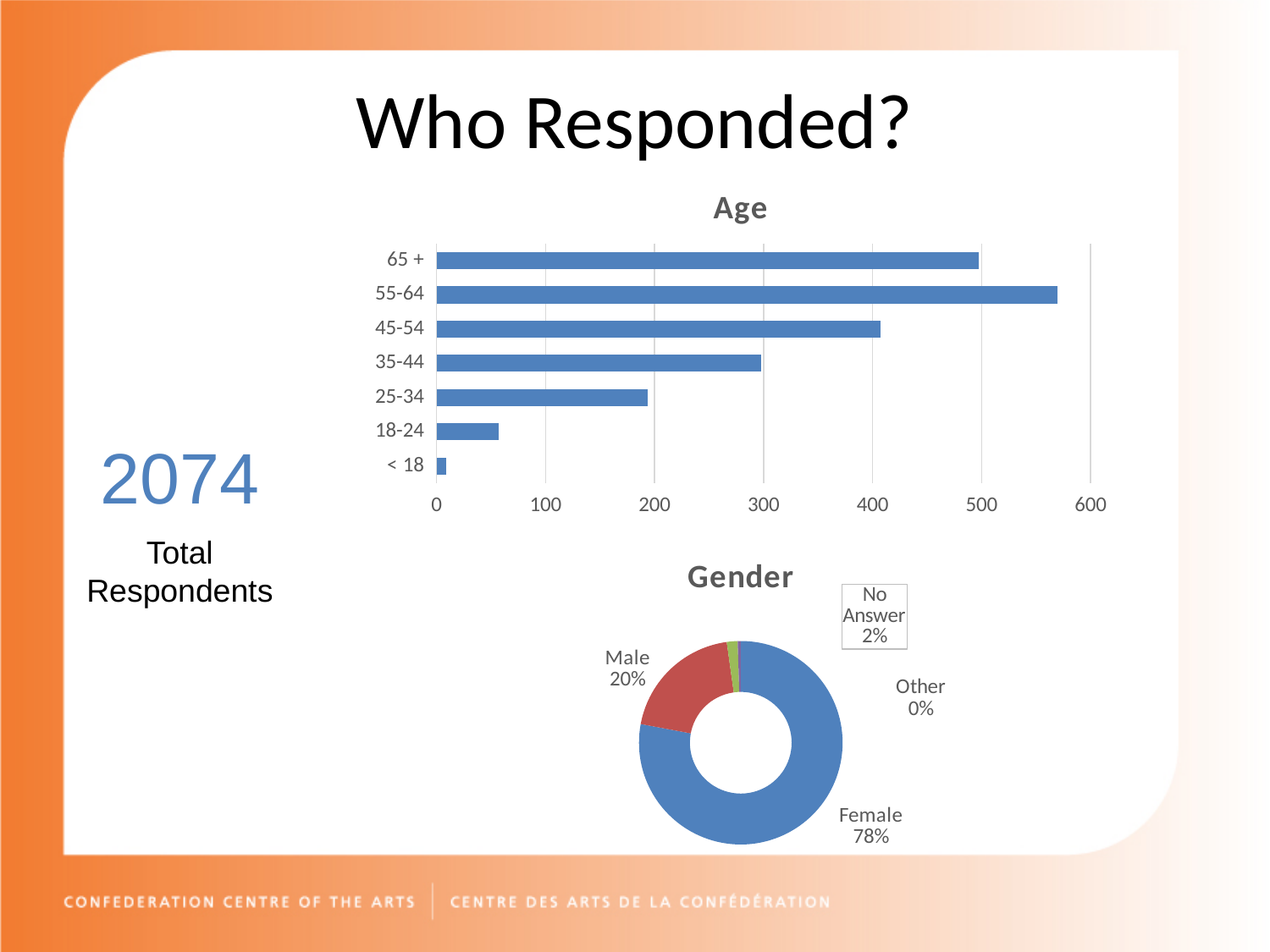
What type of chart is the Age chart? bar chart In the Gender chart, what percentage of respondents gave No Answer? 2% In the Gender chart, what percentage of respondents are Female? 78% In the Age chart, is the value for 55-64 greater or less than 500? greater In the Age chart, is the value for 18-24 greater or less than 100? less In the Gender chart, what is the difference between the Female and Male percentages? 58% In the Age chart, which age group has the lowest number of respondents? < 18 In the Age chart, which has more respondents, 45-54 or 25-34? 45-54 In the Age chart, which age group has the highest number of respondents? 55-64 In the Gender chart, what percentage of respondents are Male? 20% How many age groups are shown in the Age chart? 7